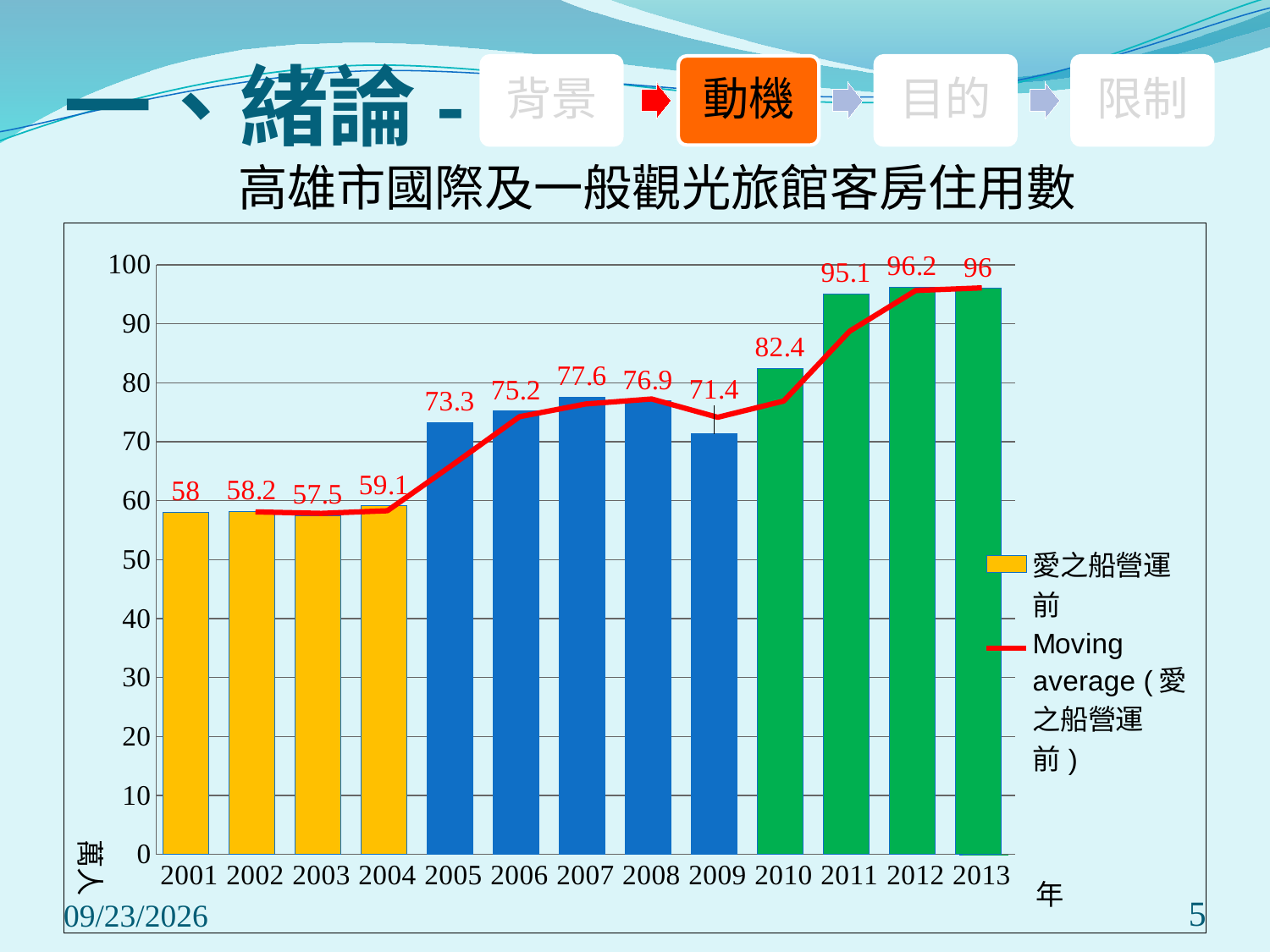
What is the value for 2003? 57.5 How many entries does the legend list? 2 What is the difference between the values for 2013 and 2001? 38 What is the value for 2010? 82.4 Which is larger, the value for 2008 or the value for 2009? 2008 How many years are shown on the x axis? 13 What is the value for 2005? 73.3 Which year has the lowest value? 2003 Which year has the highest value? 2012 What kind of chart is this? bar chart with a line What is the title of the chart? 高雄市國際及一般觀光旅館客房住用數 Is the value for 2011 greater or less than 90? greater